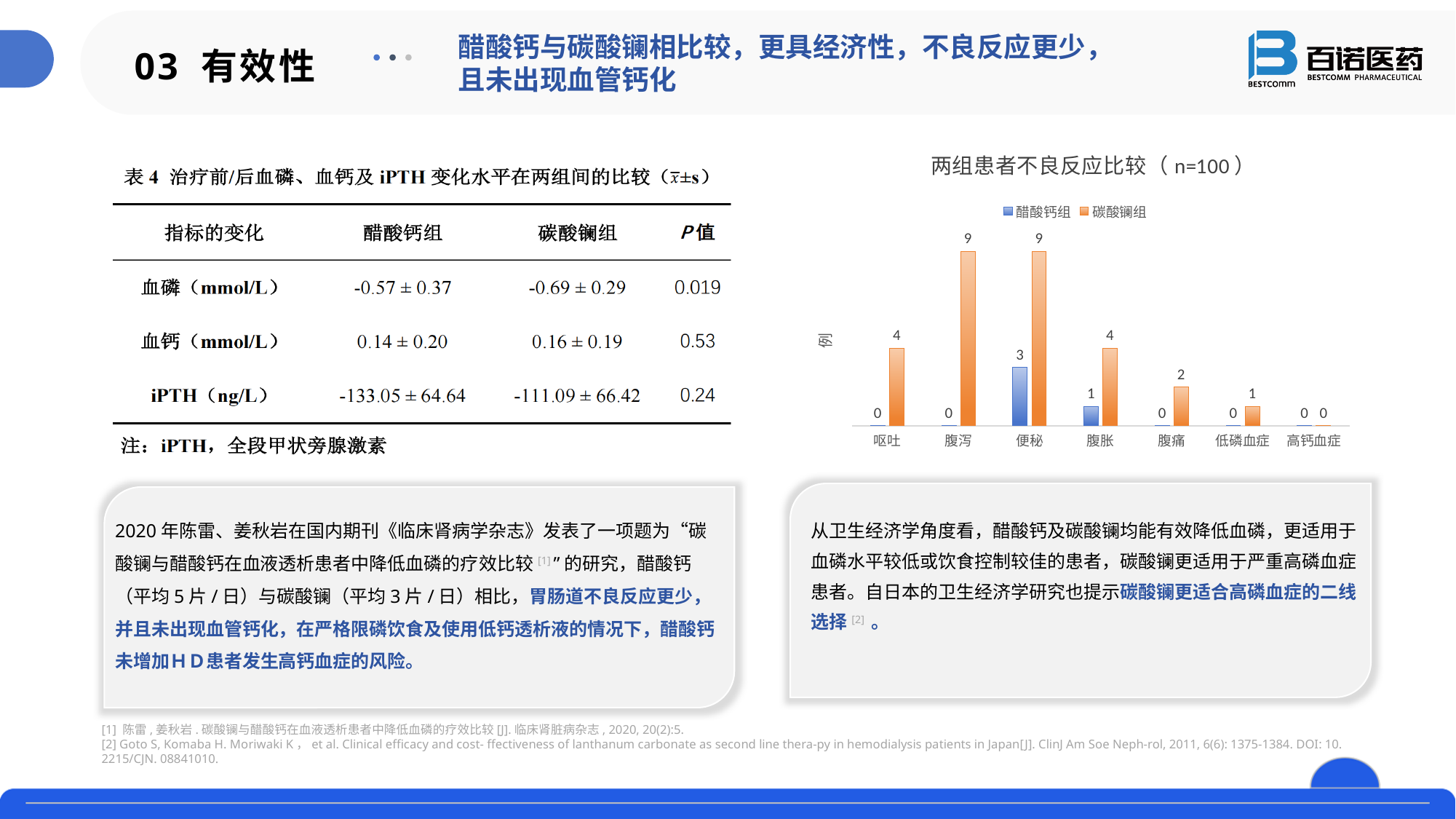
What is the value for 醋酸钙组 in the 便秘 category? 3 Which category has the lowest value for 碳酸镧组? 高钙血症 How many series does the chart legend list? 2 What is the value for 碳酸镧组 in the 腹痛 category? 2 Which category has the highest value for 醋酸钙组? 便秘 What type of chart is shown on the slide? bar chart What is the title of the chart? 两组患者不良反应比较（n=100） What is the difference between 碳酸镧组 and 醋酸钙组 in the 便秘 category? 6 What is the value for 碳酸镧组 in the 腹泻 category? 9 In the 呕吐 category, which series has the larger value, 醋酸钙组 or 碳酸镧组? 碳酸镧组 How many adverse reaction categories are shown on the x axis of the chart? 7 What is the value for 醋酸钙组 in the 腹胀 category? 1